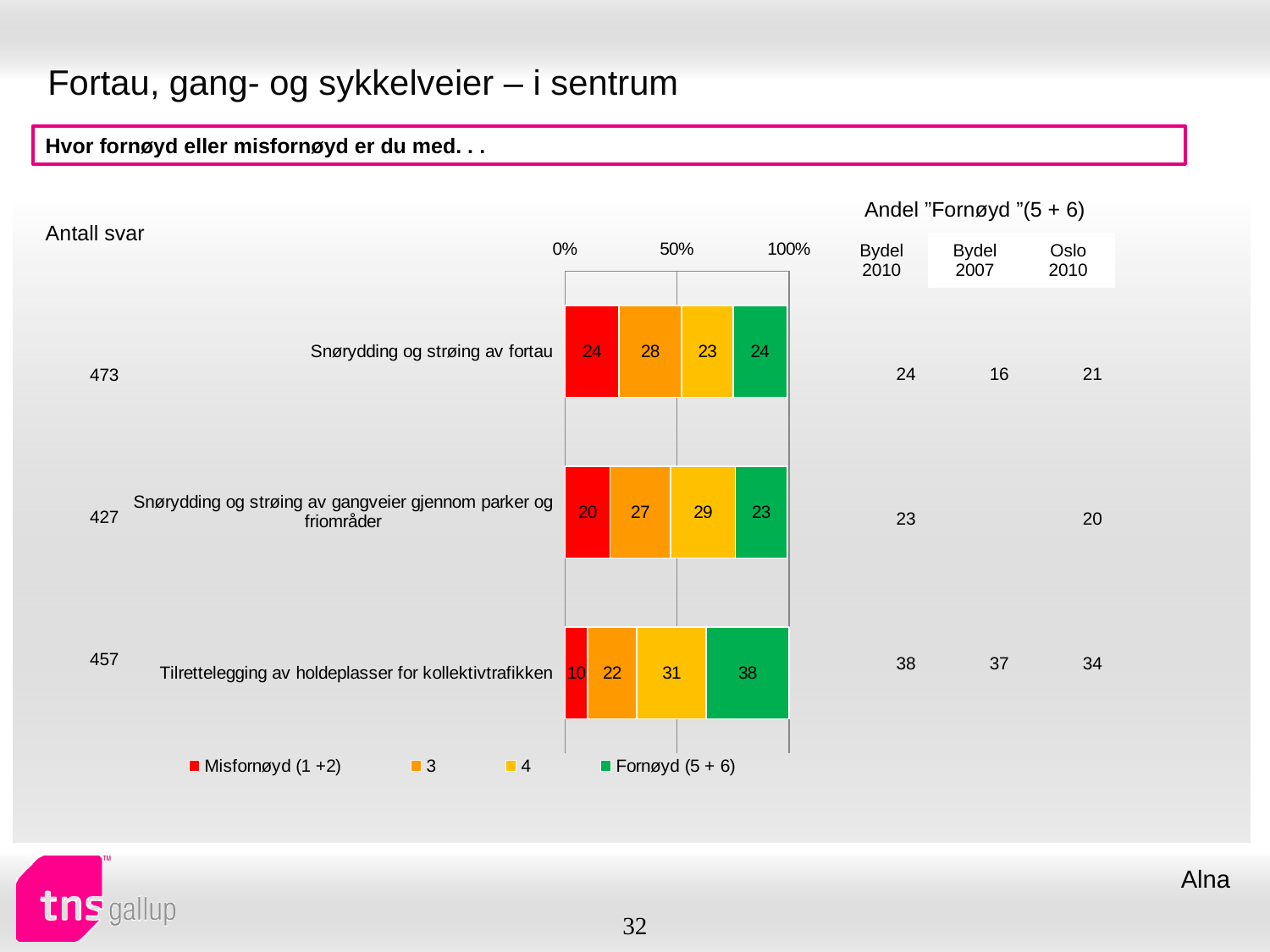
How many series does the legend list? 4 Which is larger: the '3' segment for 'Snørydding og strøing av fortau' or the '3' segment for 'Tilrettelegging av holdeplasser for kollektivtrafikken'? Snørydding og strøing av fortau What is the total of the stacked bar for 'Snørydding og strøing av gangveier gjennom parker og friområder'? 99 What kind of chart is shown on the slide? stacked bar chart Which category has the highest 'Fornøyd (5 + 6)' value? Tilrettelegging av holdeplasser for kollektivtrafikken What is the difference between the 'Fornøyd (5 + 6)' values for 'Tilrettelegging av holdeplasser for kollektivtrafikken' and 'Snørydding og strøing av fortau'? 14 What is the value of the 'Misfornøyd (1 +2)' segment for 'Tilrettelegging av holdeplasser for kollektivtrafikken'? 10 What is the value of the 'Fornøyd (5 + 6)' segment for 'Snørydding og strøing av fortau'? 24 What is the value of the '4' segment for 'Snørydding og strøing av gangveier gjennom parker og friområder'? 29 What colour represents the 'Fornøyd (5 + 6)' series in the chart? green How many categories does the chart show? 3 Which category has the lowest 'Misfornøyd (1 +2)' value? Tilrettelegging av holdeplasser for kollektivtrafikken